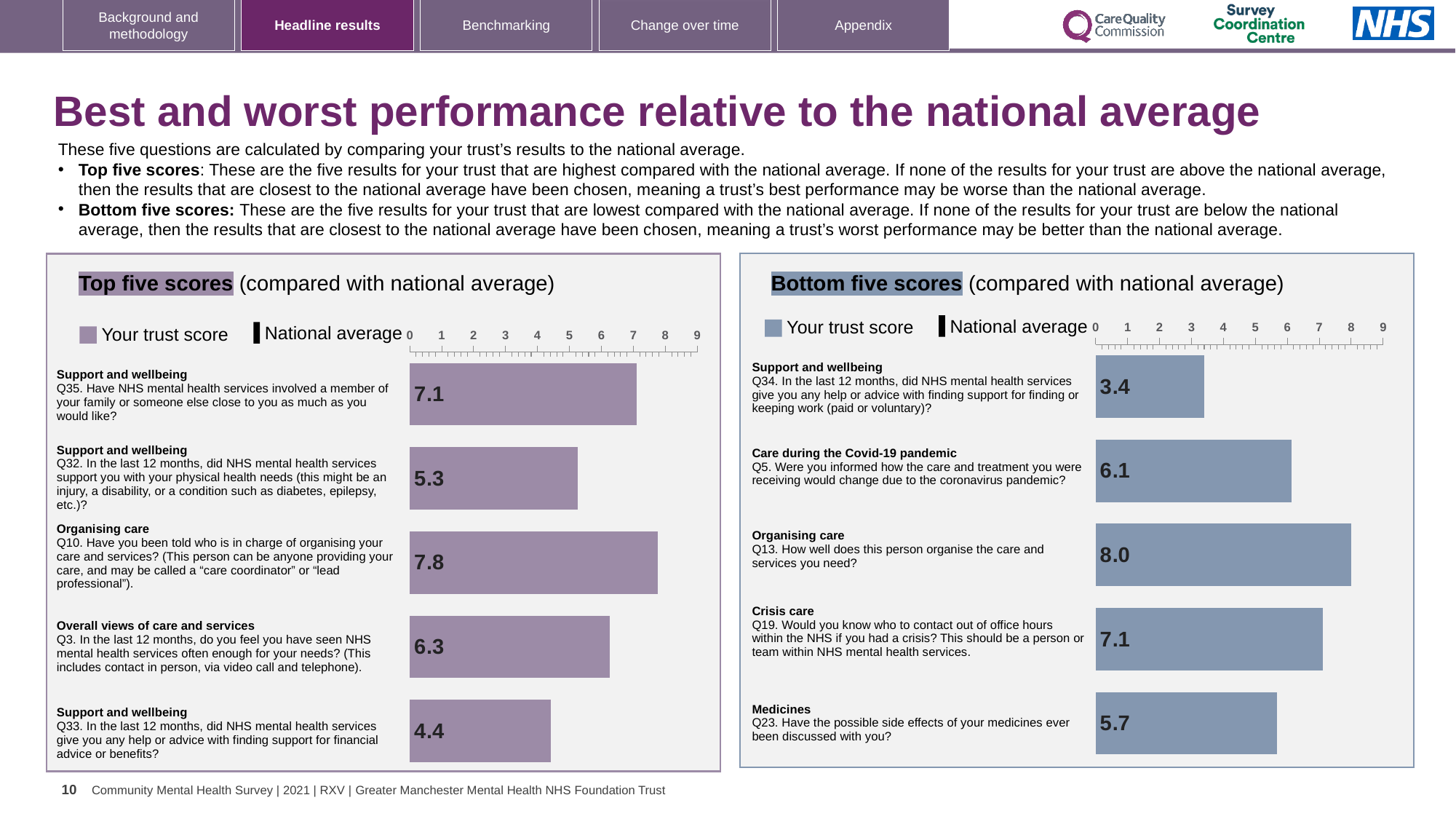
In the Top five scores chart, which has the larger trust score, Q35 or Q3? Q35 In the Top five scores chart, what is the trust score for Q33 (Support and wellbeing, financial advice or benefits)? 4.4 In the Top five scores chart, what is the difference between the trust scores for Q10 and Q33? 3.4 In the Bottom five scores chart, what is the trust score for Q23 (Medicines)? 5.7 How many entries does the legend of the Bottom five scores chart list? 2 In the Top five scores chart, what is the trust score for Q10 (Organising care)? 7.8 How many bars are shown in the Bottom five scores chart? 5 In the Top five scores chart, which question has the highest trust score? Q10 (Organising care) In the Bottom five scores chart, what is the difference between the trust scores for Q13 and Q34? 4.6 In the Bottom five scores chart, which question has the lowest trust score? Q34 (Support and wellbeing) What kind of chart is the Top five scores chart? Bar chart In the Bottom five scores chart, what is the trust score for Q34 (Support and wellbeing, finding or keeping work)? 3.4